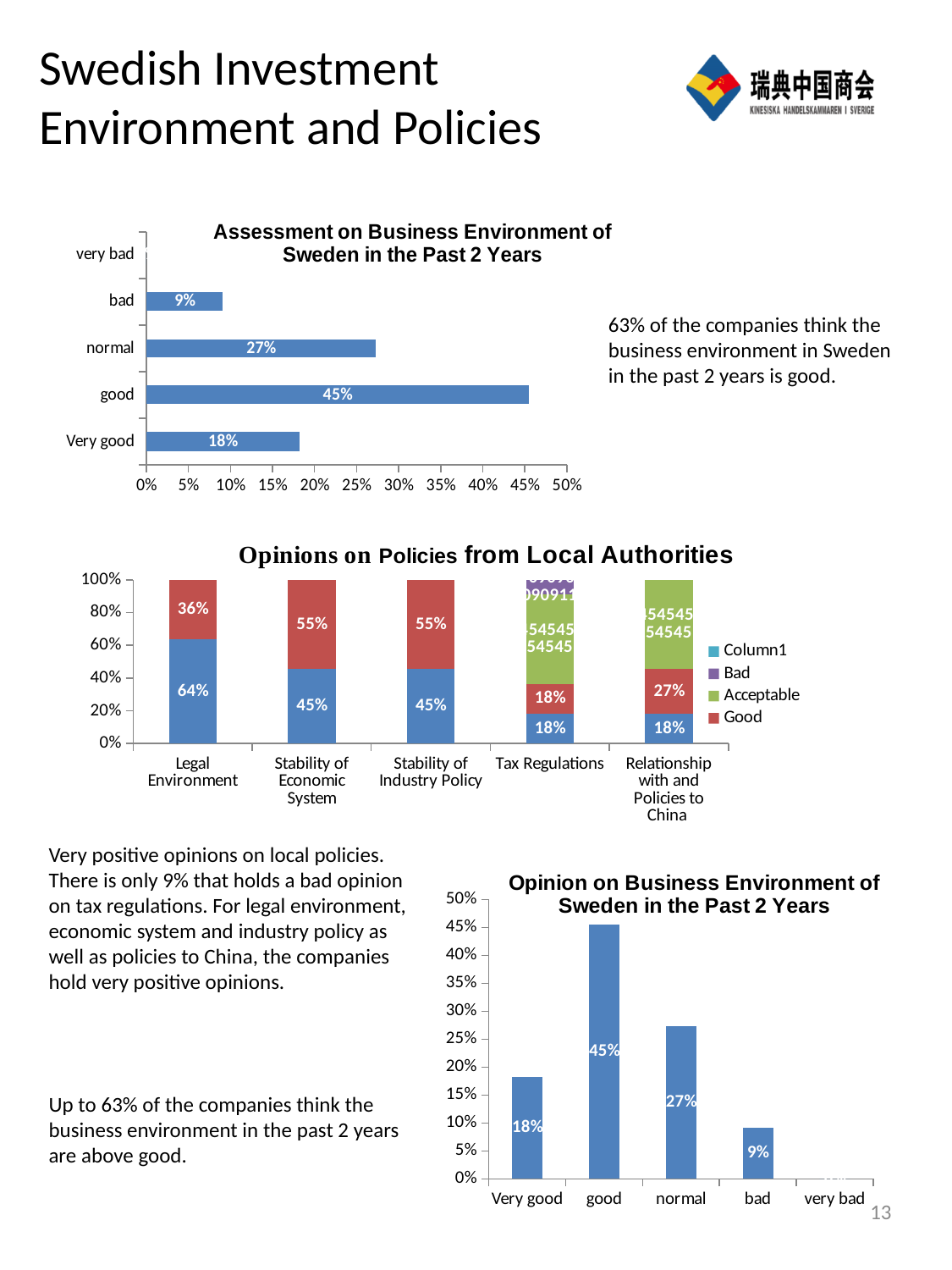
In the 'Assessment on Business Environment of Sweden in the Past 2 Years' chart, which category has the highest value? good In the 'Opinions on Policies from Local Authorities' chart, what is the 'Good' value for 'Stability of Economic System'? 55% In the 'Opinions on Policies from Local Authorities' chart, what is the 'Good' value for 'Legal Environment'? 36% In the 'Opinions on Policies from Local Authorities' chart, which is larger: the 'Good' value for 'Legal Environment' or the 'Good' value for 'Tax Regulations'? Legal Environment In the 'Opinion on Business Environment of Sweden in the Past 2 Years' chart, is the value for 'good' greater or less than 40%? greater In the 'Opinions on Policies from Local Authorities' chart, how many entries does the legend list? 4 In the 'Assessment on Business Environment of Sweden in the Past 2 Years' chart, what kind of chart is shown? bar chart In the 'Assessment on Business Environment of Sweden in the Past 2 Years' chart, what is the value for 'normal'? 27% In the 'Opinion on Business Environment of Sweden in the Past 2 Years' chart, what is the value for 'bad'? 9% In the 'Opinion on Business Environment of Sweden in the Past 2 Years' chart, what is the difference between the values for 'Very good' and 'normal'? 9% In the 'Opinions on Policies from Local Authorities' chart, how many categories are shown on the x axis? 5 In the 'Assessment on Business Environment of Sweden in the Past 2 Years' chart, what is the difference between the values for 'good' and 'bad'? 36%